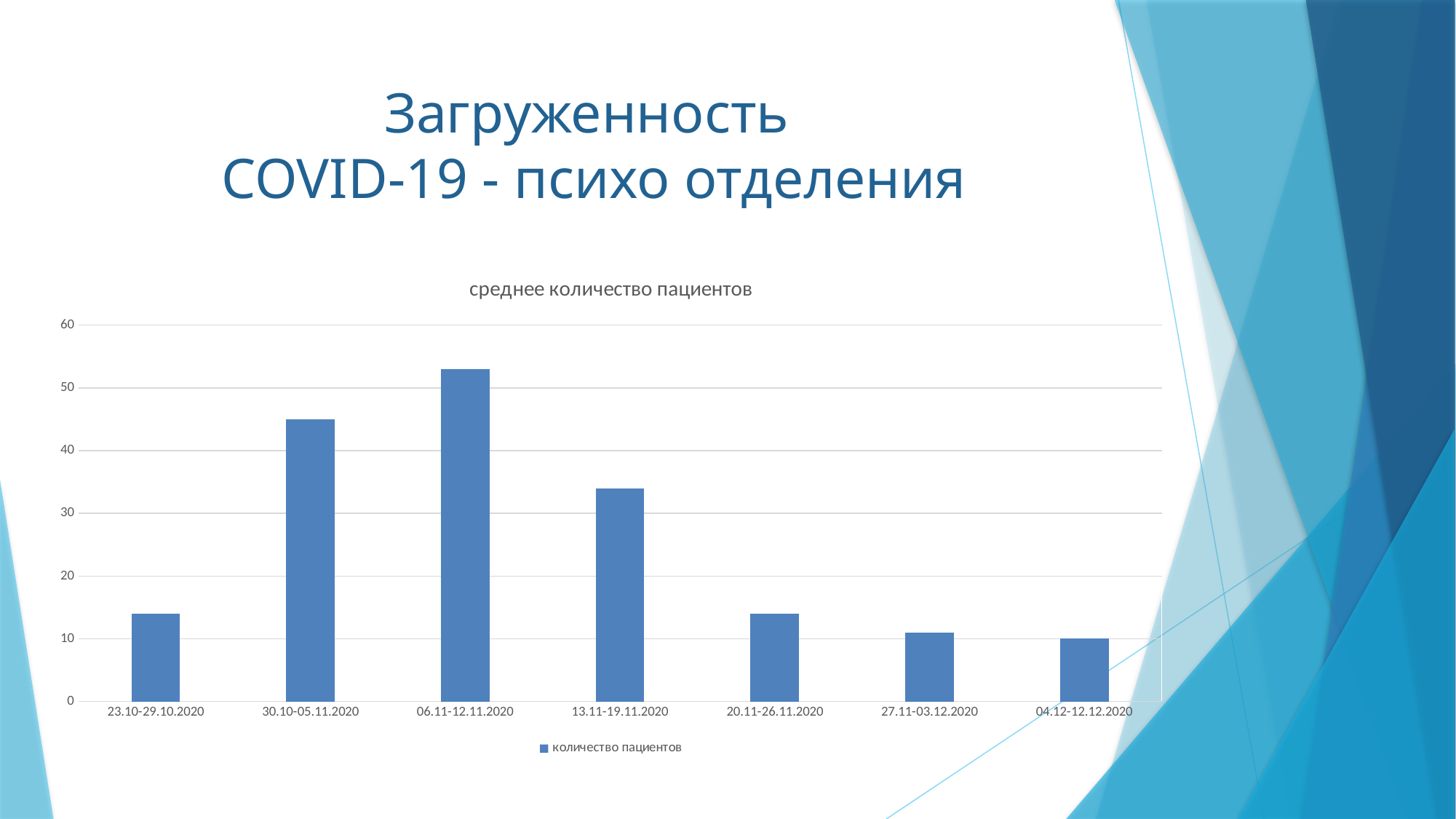
Do the values rise or fall from 06.11-12.11.2020 to 04.12-12.12.2020? fall Is the value for 06.11-12.11.2020 greater or less than 50? greater Is the value for 13.11-19.11.2020 greater or less than 30? greater How many series does the chart legend list? 1 Is the value for 27.11-03.12.2020 greater or less than 20? less What kind of chart is shown on the slide? bar chart What is the title of the chart? среднее количество пациентов Which is larger, the value for 30.10-05.11.2020 or the value for 13.11-19.11.2020? 30.10-05.11.2020 How many date periods are shown on the x axis of the chart? 7 Which period has the highest average number of patients? 06.11-12.11.2020